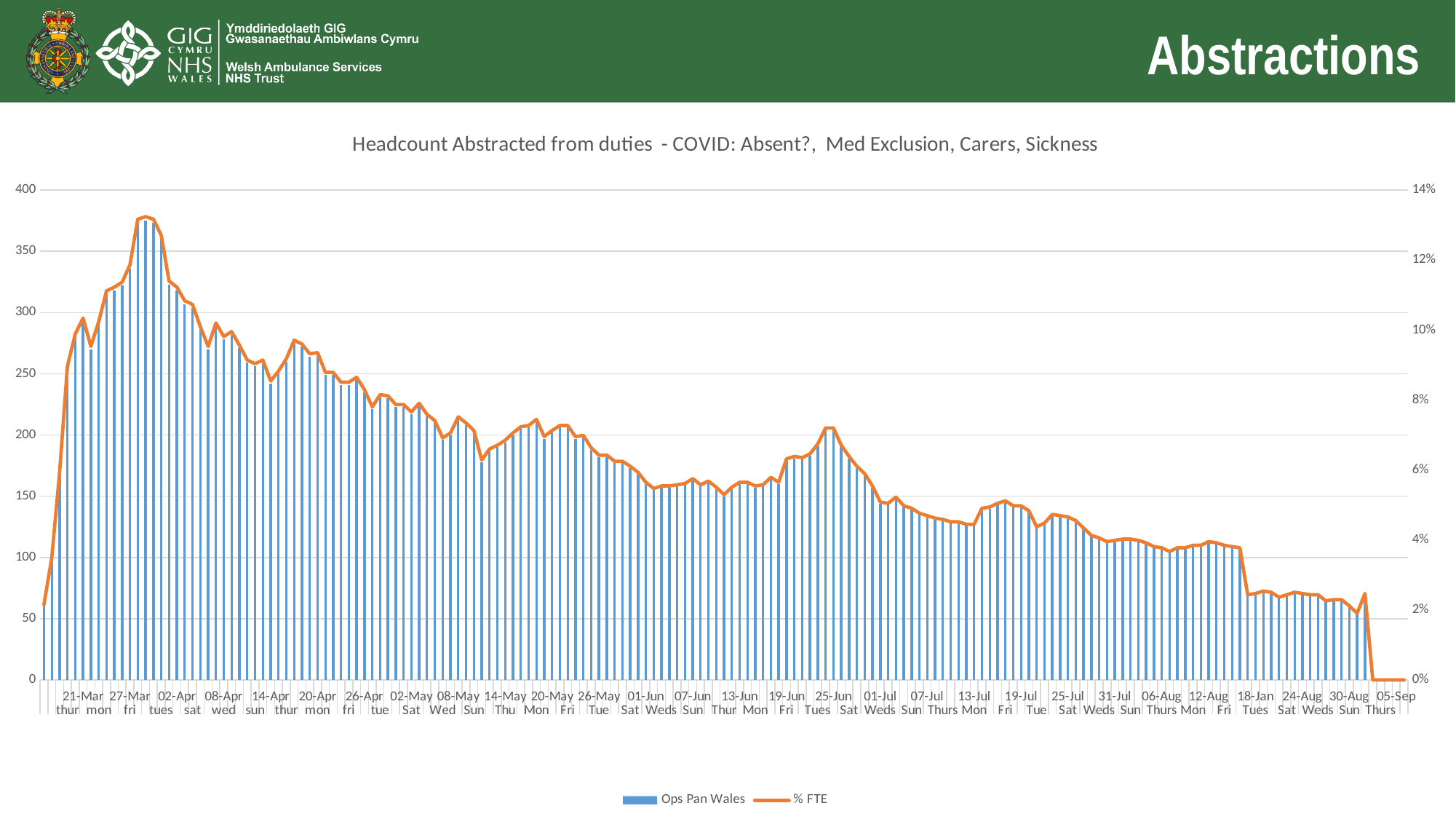
What are the two series named in the legend? Ops Pan Wales and % FTE Is the Ops Pan Wales value for 25-Jun greater or less than 150? greater Which has the larger Ops Pan Wales value, 14-Apr or 14-May? 14-Apr Is the Ops Pan Wales value for 01-Jul greater or less than 200? less What is the highest value shown on the right-hand (percentage) axis? 14% Is the Ops Pan Wales value for 05-Sep greater or less than 50? less Do the Ops Pan Wales values generally rise or fall from April through to September? fall What kind of chart is shown on the slide? A combined bar and line chart How many series does the legend list? 2 What is the title of the chart? Headcount Abstracted from duties - COVID: Absent?, Med Exclusion, Carers, Sickness